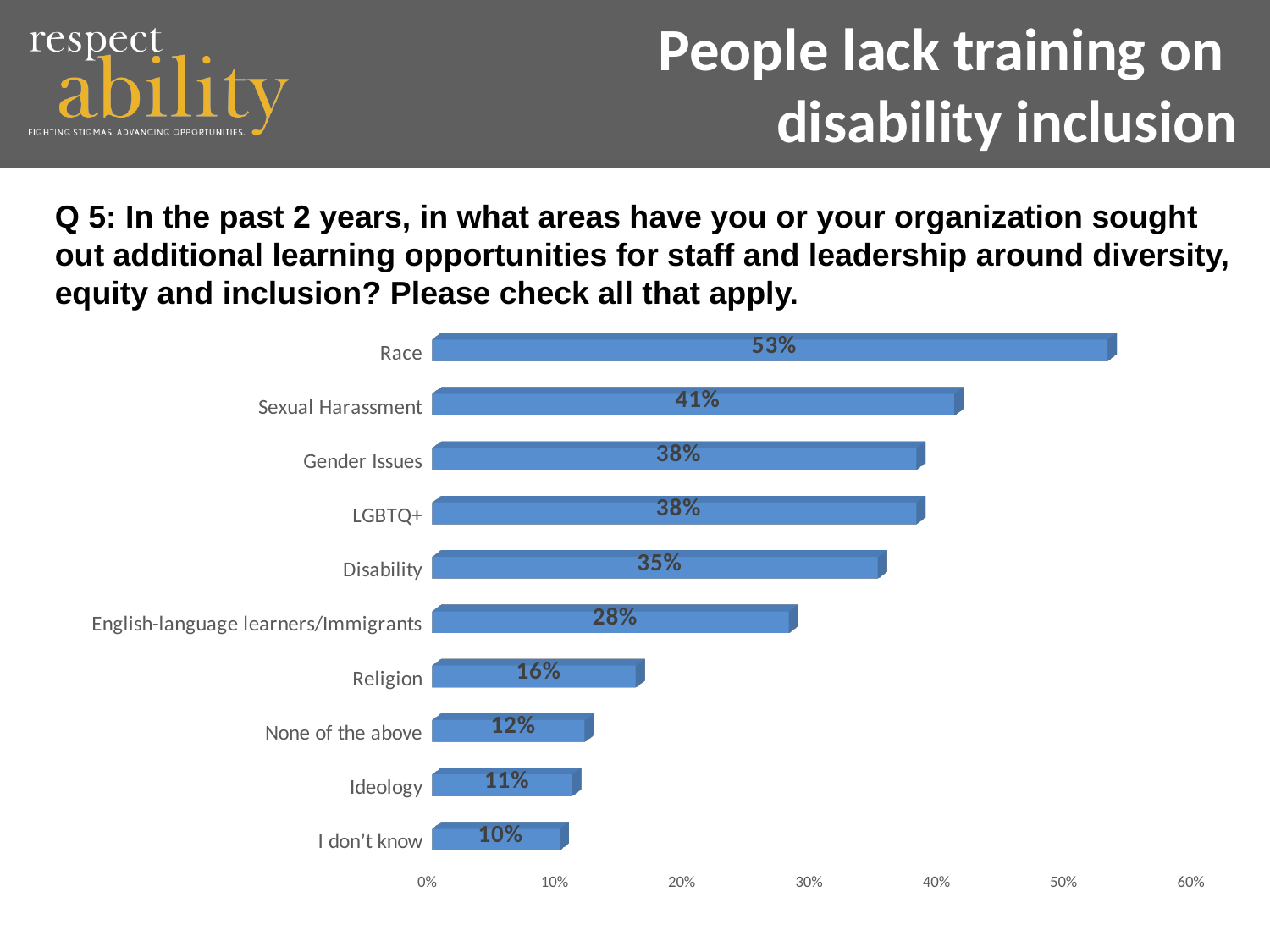
Is the value for Religion greater or less than 20%? less What kind of chart is shown on the slide? bar chart Which category has the lowest value? I don't know What is the difference between the values for Disability and Religion? 19% How many categories are shown in the chart? 10 What percentage is shown for English-language learners/Immigrants? 28% What is the difference between the values for Race and Sexual Harassment? 12% What percentage is shown for Race? 53% Which is larger, the value for Sexual Harassment or the value for Disability? Sexual Harassment What is the highest value shown on the horizontal axis? 60% What percentage is shown for Disability? 35% Which category has the highest value? Race